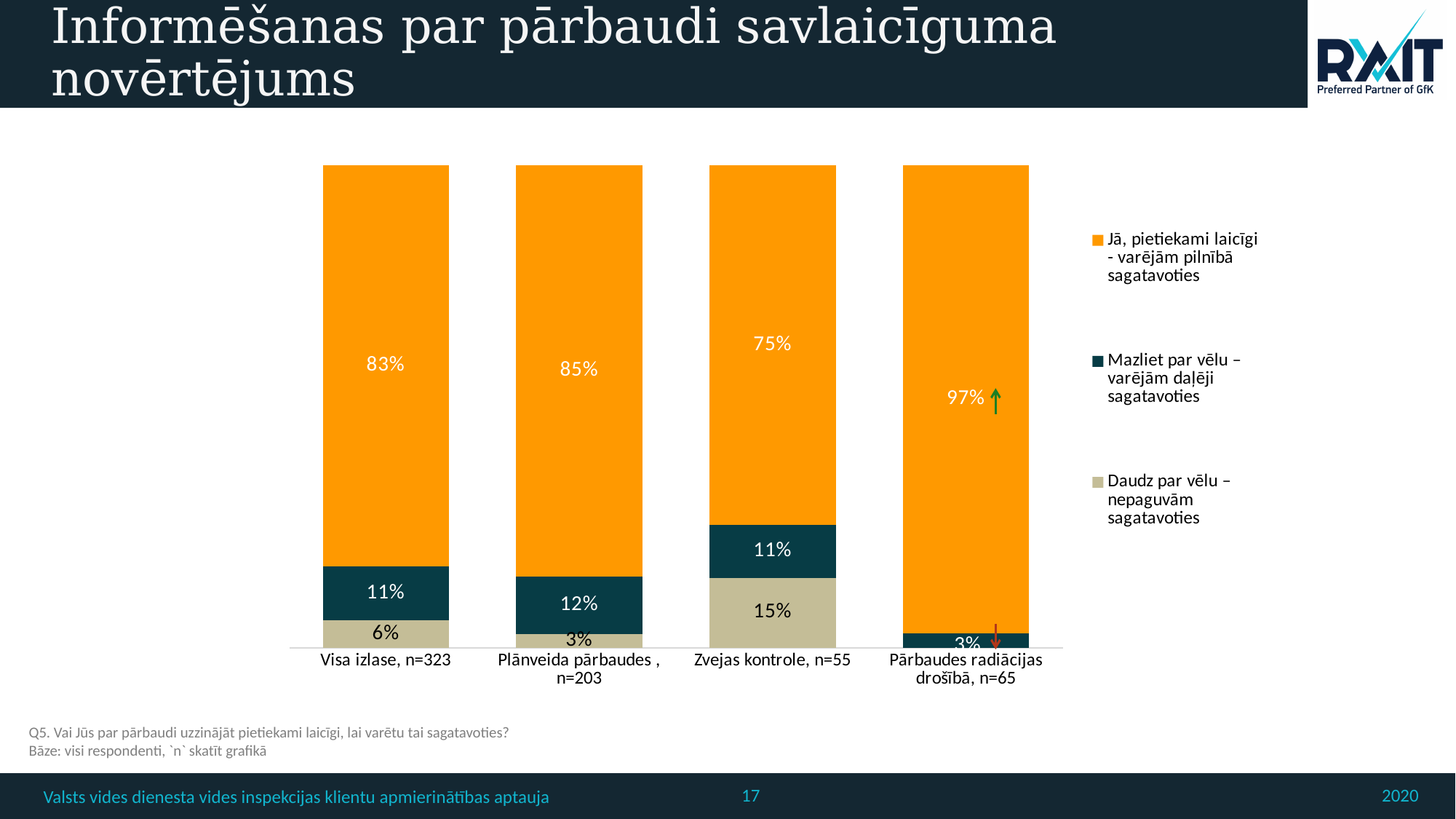
How many series does the legend list? 3 What percentage of respondents in the 'Visa izlase, n=323' group answered 'Jā, pietiekami laicīgi - varējām pilnībā sagatavoties'? 83% Which category has the highest share of 'Jā, pietiekami laicīgi - varējām pilnībā sagatavoties'? Pārbaudes radiācijas drošībā, n=65 What is the value of the 'Mazliet par vēlu – varējām daļēji sagatavoties' segment for 'Pārbaudes radiācijas drošībā, n=65'? 3% Which category has the lowest share of 'Jā, pietiekami laicīgi - varējām pilnībā sagatavoties'? Zvejas kontrole, n=55 What is the difference between the 'Jā, pietiekami laicīgi' share for 'Pārbaudes radiācijas drošībā, n=65' and for 'Zvejas kontrole, n=55'? 22 percentage points What is the value of the 'Daudz par vēlu – nepaguvām sagatavoties' segment for 'Zvejas kontrole, n=55'? 15% Which is larger: the 'Daudz par vēlu' share for 'Visa izlase, n=323' or for 'Plānveida pārbaudes, n=203'? Visa izlase, n=323 What type of chart is shown on the slide? Stacked bar chart What is the value of the 'Mazliet par vēlu – varējām daļēji sagatavoties' segment for 'Plānveida pārbaudes, n=203'? 12% How many categories are shown on the x axis of the chart? 4 What colour represents the 'Jā, pietiekami laicīgi - varējām pilnībā sagatavoties' series? Orange